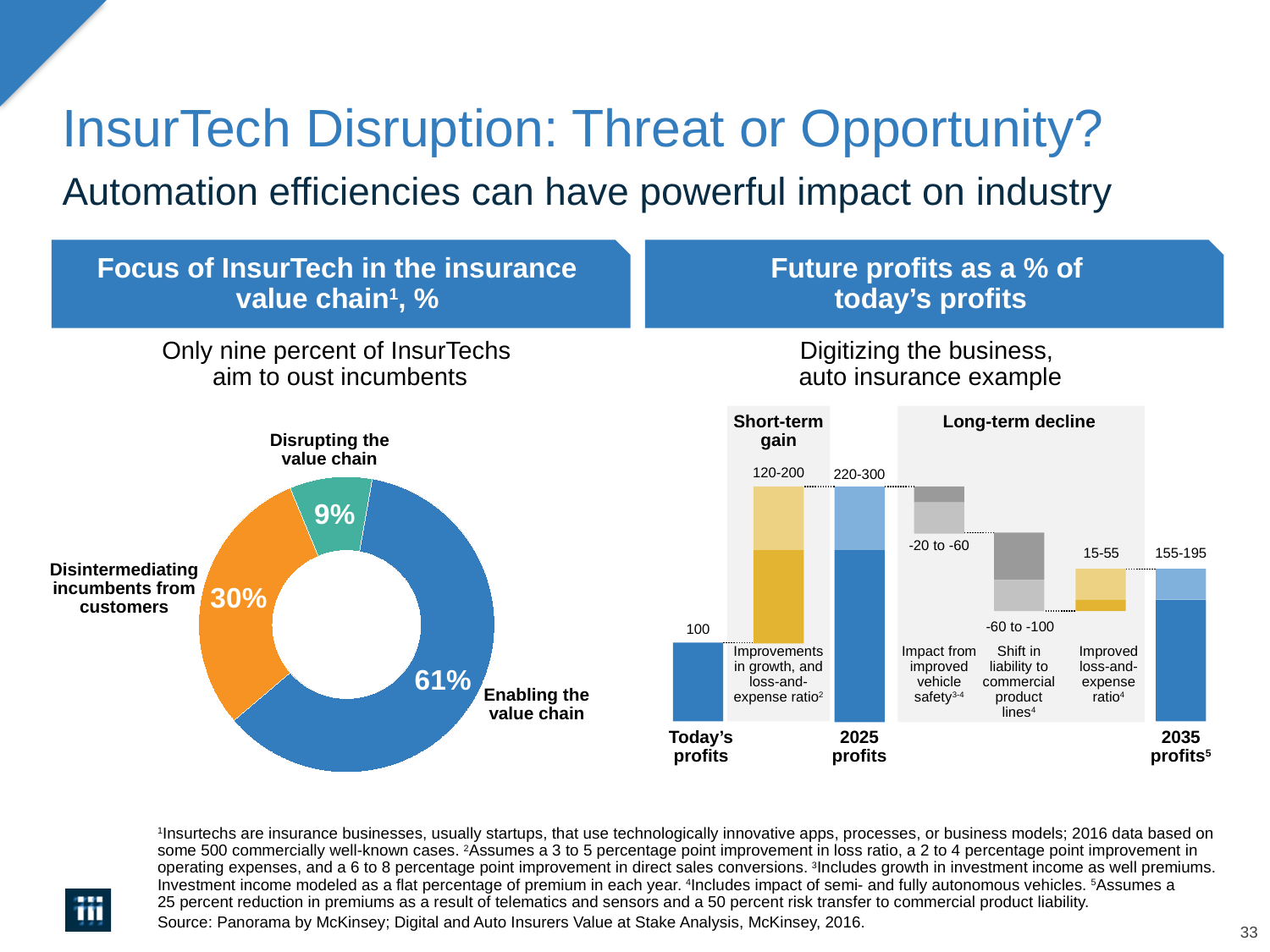
What kind of chart is the 'Focus of InsurTech in the insurance value chain' chart? Donut (pie) chart In the 'Future profits as a % of today's profits' chart, what range is shown for 'Shift in liability to commercial product lines'? -60 to -100 How many segments does the 'Focus of InsurTech in the insurance value chain' chart have? 3 In the 'Focus of InsurTech in the insurance value chain' chart, what share is labelled for 'Disintermediating incumbents from customers'? 30% In the 'Focus of InsurTech in the insurance value chain' chart, what share is labelled for 'Disrupting the value chain'? 9% In the 'Focus of InsurTech in the insurance value chain' chart, what share is labelled for 'Enabling the value chain'? 61% In the 'Future profits as a % of today's profits' chart, what value is shown for 'Today's profits'? 100 In the 'Future profits as a % of today's profits' chart, what range is shown for '2025 profits'? 220-300 In the 'Future profits as a % of today's profits' chart, what range is shown for '2035 profits'? 155-195 In the 'Focus of InsurTech in the insurance value chain' chart, which segment is the smallest? Disrupting the value chain In the 'Focus of InsurTech in the insurance value chain' chart, how many percentage points larger is 'Enabling the value chain' than 'Disintermediating incumbents from customers'? 31 In the 'Focus of InsurTech in the insurance value chain' chart, which segment is the largest? Enabling the value chain